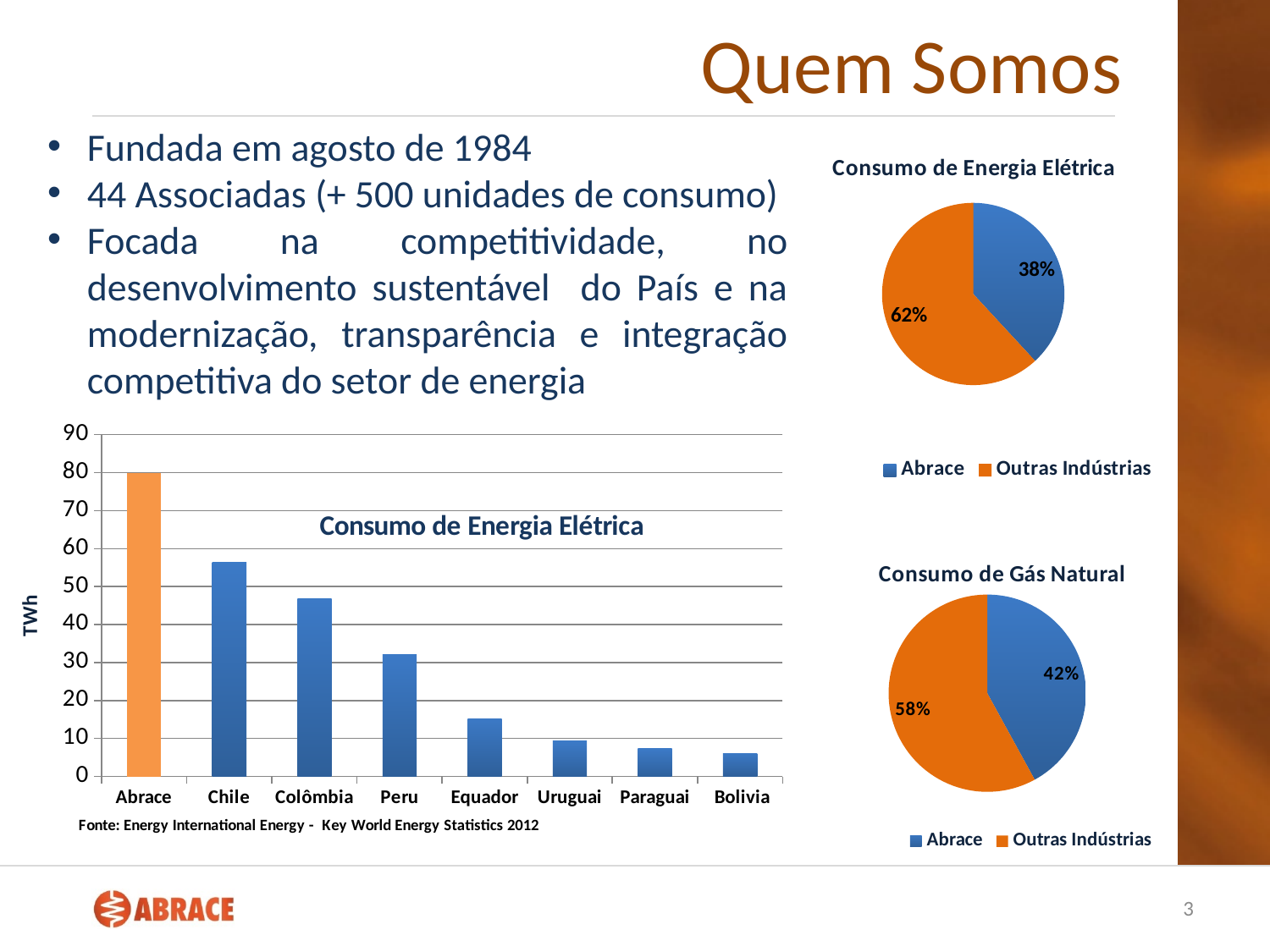
In the pie chart titled 'Consumo de Gás Natural' at the bottom right, what is the difference between the Outras Indústrias share and the Abrace share? 16% In the pie chart titled 'Consumo de Gás Natural' at the bottom right, what share does Abrace have? 42% In the bar chart titled 'Consumo de Energia Elétrica' at the bottom left, how many categories are shown on the x axis? 8 In the pie chart titled 'Consumo de Energia Elétrica' at the top right, what share does Abrace have? 38% In the bar chart titled 'Consumo de Energia Elétrica' at the bottom left, is the value for Peru greater or less than 40? less In the bar chart titled 'Consumo de Energia Elétrica' at the bottom left, which country has the highest value? Abrace In the pie chart titled 'Consumo de Energia Elétrica' at the top right, what share do Outras Indústrias have? 62% In the bar chart titled 'Consumo de Energia Elétrica' at the bottom left, what unit is shown on the y axis label? TWh In the bar chart titled 'Consumo de Energia Elétrica' at the bottom left, is the value for Chile greater or less than 50? greater In the pie chart titled 'Consumo de Gás Natural' at the bottom right, how many entries does the legend list? 2 In the bar chart titled 'Consumo de Energia Elétrica' at the bottom left, which is larger, Colômbia or Equador? Colômbia In the bar chart titled 'Consumo de Energia Elétrica' at the bottom left, which category has the lowest value? Bolivia